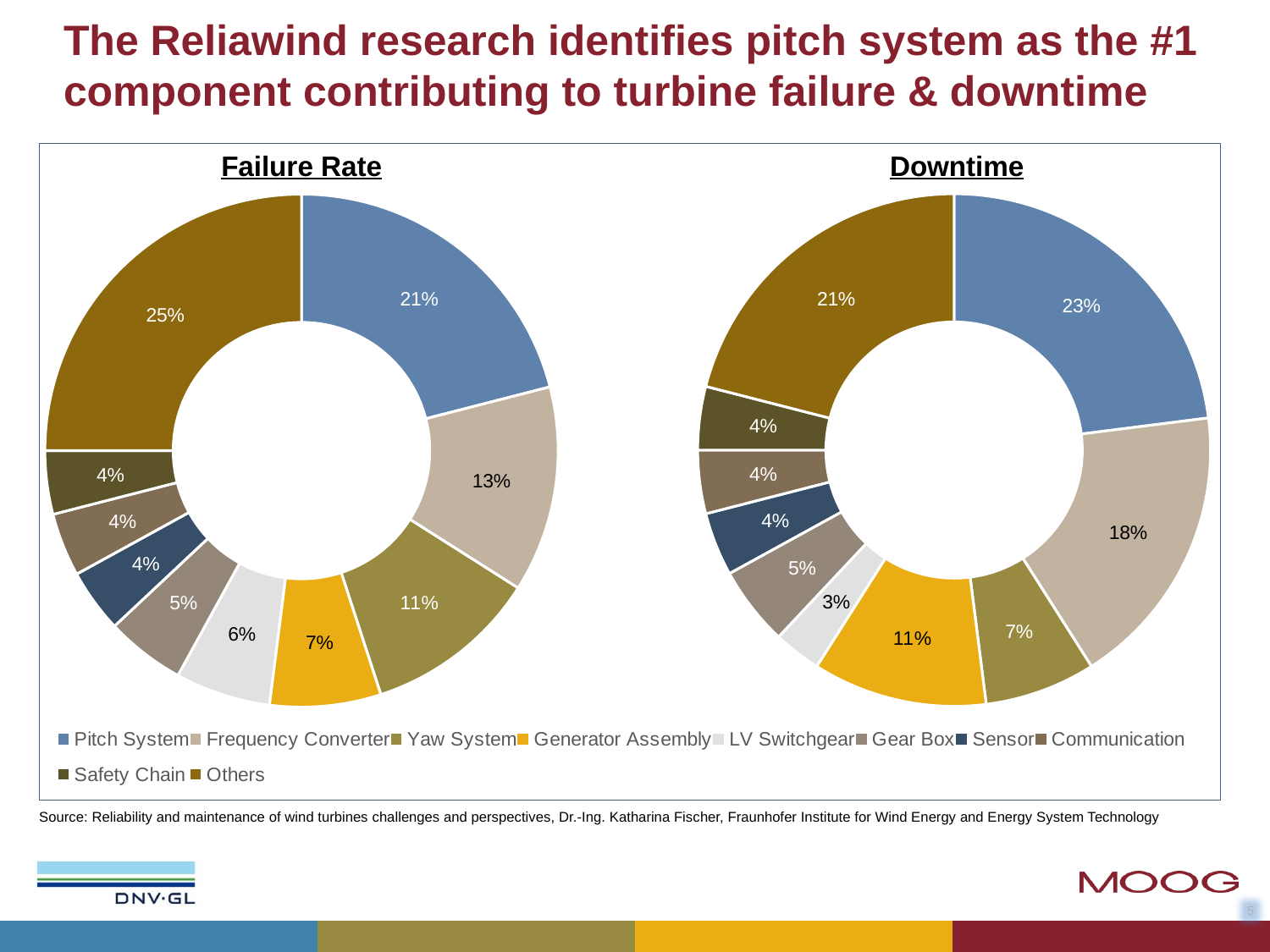
In the Failure Rate chart, which category has the largest share? Others In the Downtime chart, which is larger: Generator Assembly or Yaw System? Generator Assembly What kind of chart is the Failure Rate chart? Pie chart (doughnut) In the Failure Rate chart, what share does Pitch System have? 21% In the Downtime chart, which category has the smallest share? LV Switchgear In the Failure Rate chart, which is larger: Frequency Converter or Yaw System? Frequency Converter In the Downtime chart, what share does Pitch System have? 23% In the Downtime chart, what share does Frequency Converter have? 18% In the Failure Rate chart, what share does Generator Assembly have? 7% How many categories does the legend list? 10 In the Downtime chart, what is the difference between the Pitch System share and the Frequency Converter share? 5% What is the title of the chart on the right? Downtime